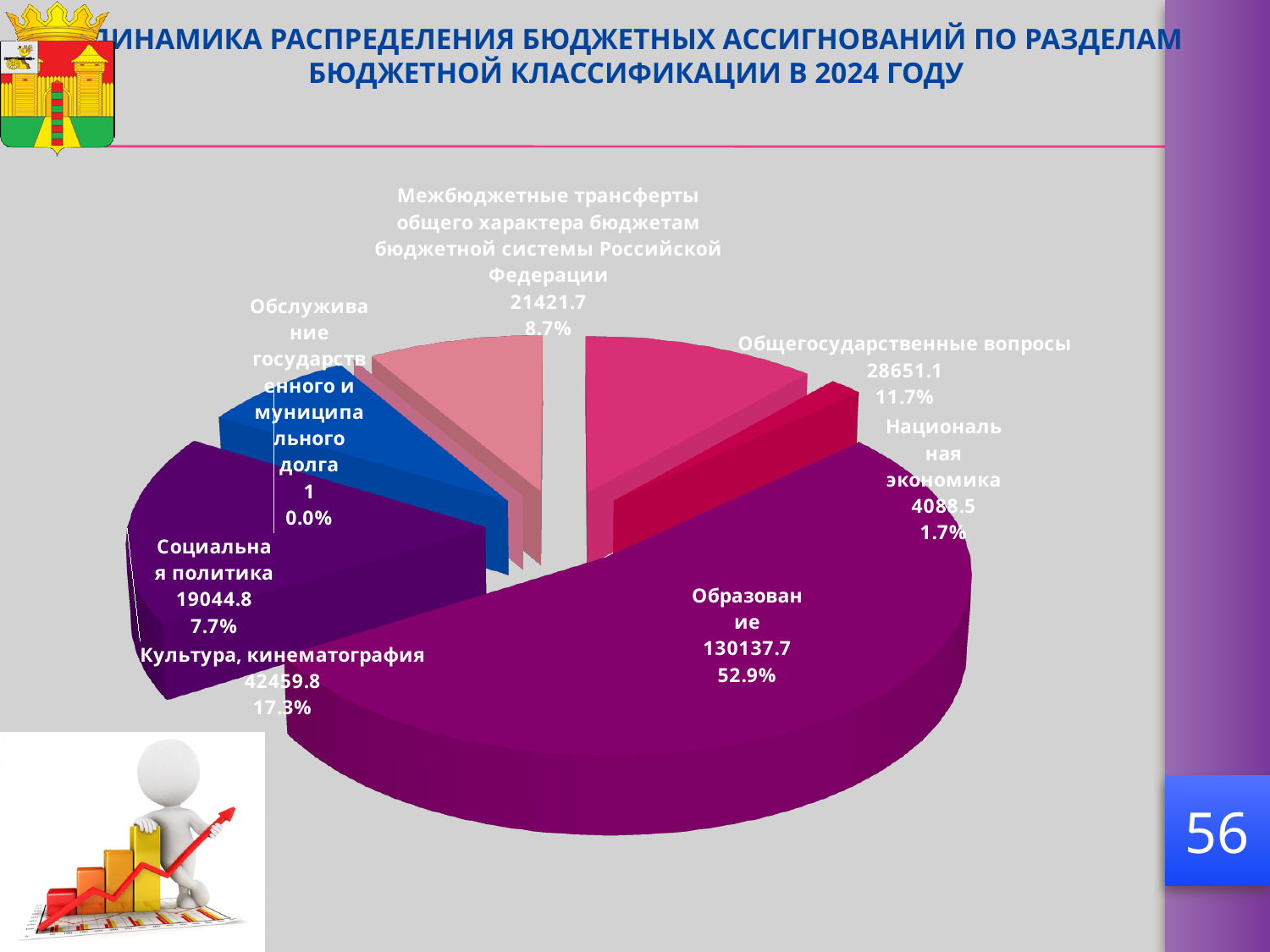
What percentage is shown for Общегосударственные вопросы? 11.7% Which category has the largest share of the pie? Образование What kind of chart is shown on the slide? Pie chart What is the value shown for Культура, кинематография? 42459.8 What share of the pie does Образование represent? 52.9% Which category has the smallest share of the pie? Обслуживание государственного и муниципального долга Which is larger: Социальная политика or Межбюджетные трансферты общего характера бюджетам бюджетной системы Российской Федерации? Межбюджетные трансферты общего характера бюджетам бюджетной системы Российской Федерации What is the value shown for Образование? 130137.7 What percentage is shown for Социальная политика? 7.7% How many categories (slices) does the pie chart show? 7 What is the difference between the values for Общегосударственные вопросы and Социальная политика? 9606.3 What is the value shown for Национальная экономика? 4088.5